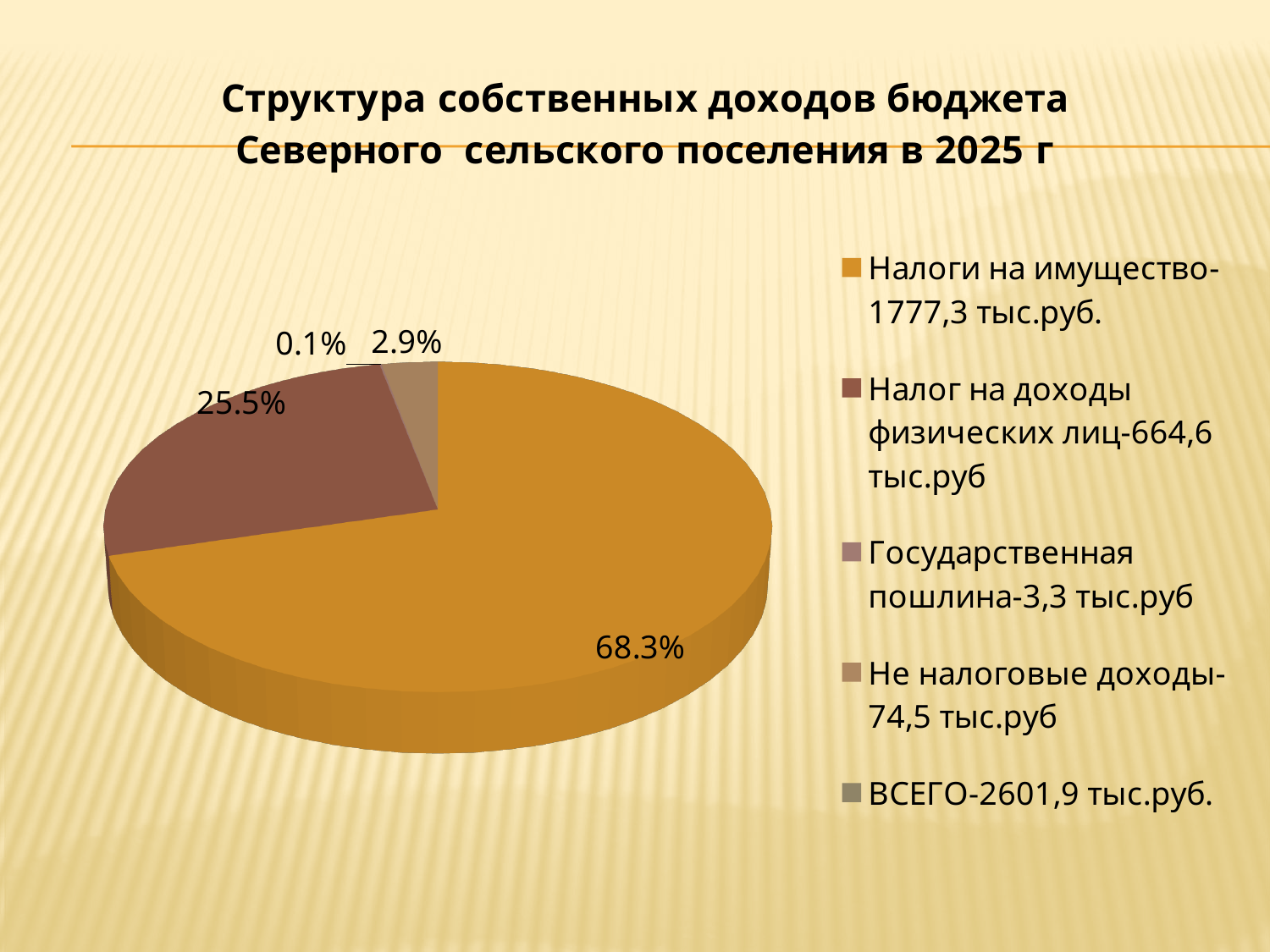
What total amount (ВСЕГО) is given in the legend? 2601,9 тыс.руб. What amount in тыс.руб. does the legend give for Налоги на имущество? 1777,3 тыс.руб. What share of the pie is labelled for Налог на доходы физических лиц? 25.5% How many entries does the legend list? 5 What kind of chart is shown on the slide? pie chart What share of the pie is labelled for Налоги на имущество? 68.3% Which category has the smallest slice of the pie? Государственная пошлина Which slice is larger: Не налоговые доходы or Государственная пошлина? Не налоговые доходы Which category has the largest slice of the pie? Налоги на имущество What share of the pie is labelled for Государственная пошлина? 0.1% What is the difference in percentage points between the Налоги на имущество slice and the Налог на доходы физических лиц slice? 42.8